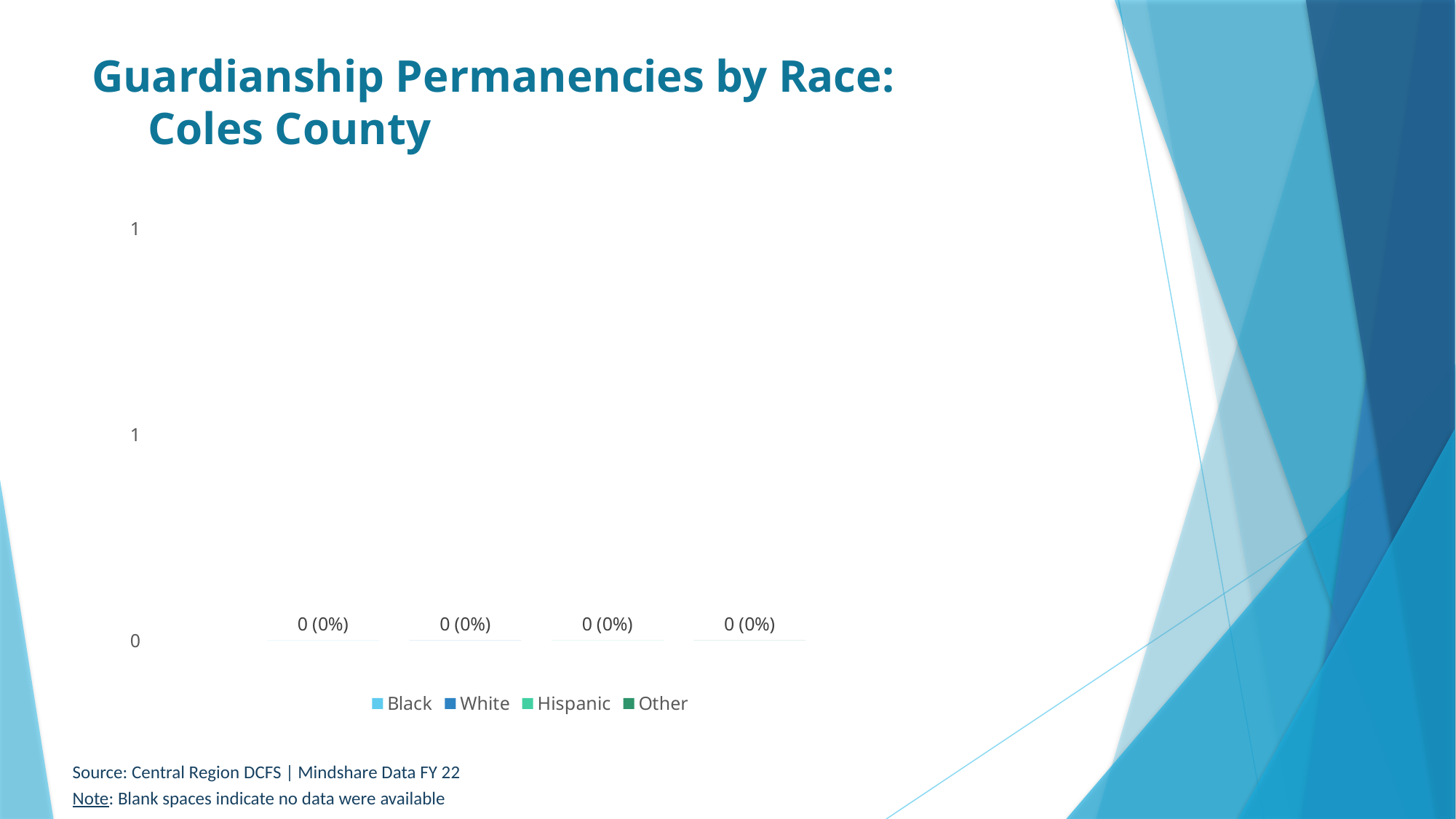
How many data labels are shown on the chart? 4 What is the data label shown for the White series? 0 (0%) Which legend entry is listed first? Black What is the data label shown for the Black series? 0 (0%) What is the data label shown for the Hispanic series? 0 (0%) How many series does the legend list? 4 What is the title of the slide containing the chart? Guardianship Permanencies by Race: Coles County What is the total of the values for Black, White, Hispanic and Other? 0 What is the difference between the values for Black and White? 0 What is the data label shown for the Other series? 0 (0%) What kind of chart is shown on the slide? bar chart Is the value for Hispanic greater or less than 1? less